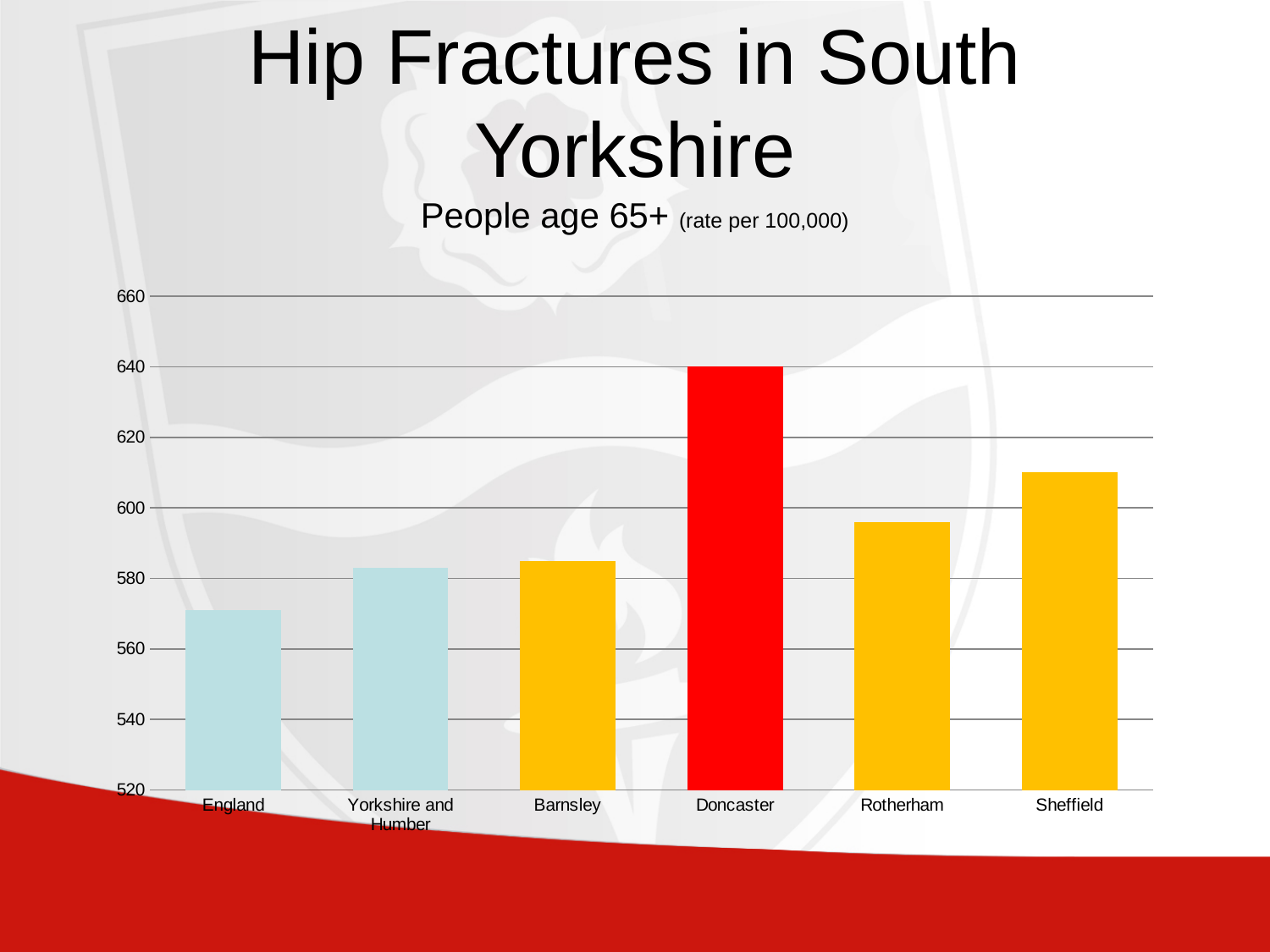
Is the value for England greater or less than 580? less How many categories are plotted on the chart? 6 What colour is the Doncaster bar? red Is the value for Doncaster greater or less than 620? greater What is the title of the slide? Hip Fractures in South Yorkshire Which category has the highest hip fracture rate? Doncaster Which has a higher value, Doncaster or Sheffield? Doncaster Is the value for Sheffield greater or less than 600? greater Which category has the lowest hip fracture rate? England Which has a higher value, Sheffield or Rotherham? Sheffield What kind of chart is shown on the slide? bar chart